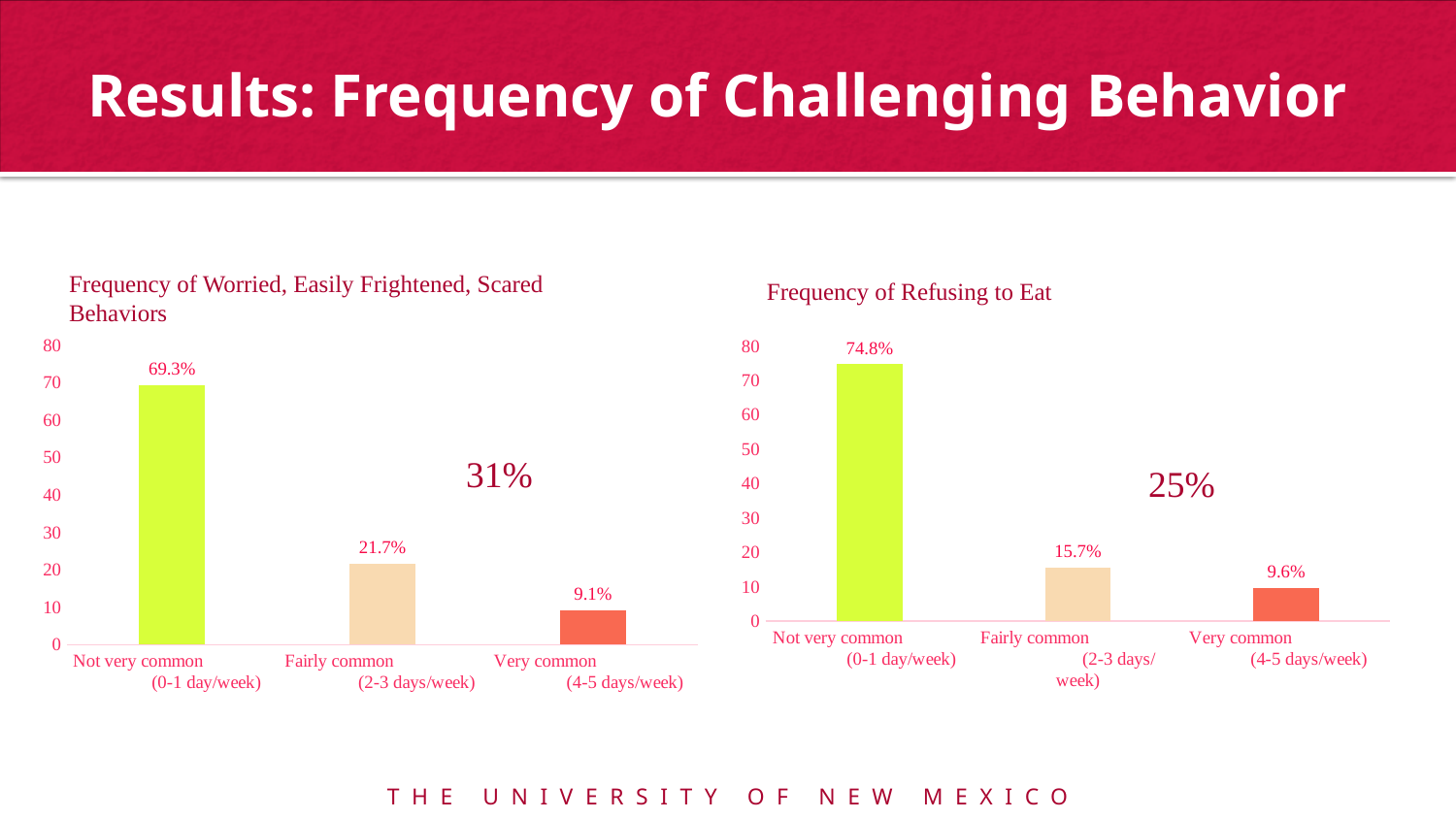
In the 'Frequency of Refusing to Eat' chart, what is the value for Fairly common (2-3 days/week)? 15.7% In the 'Frequency of Refusing to Eat' chart, what is the difference between the Fairly common and Very common values? 6.1% In the 'Frequency of Worried, Easily Frightened, Scared Behaviors' chart, what is the value for Not very common (0-1 day/week)? 69.3% In the 'Frequency of Worried, Easily Frightened, Scared Behaviors' chart, what is the value for Very common (4-5 days/week)? 9.1% In the 'Frequency of Refusing to Eat' chart, what is the value for Not very common (0-1 day/week)? 74.8% What type of chart is the 'Frequency of Worried, Easily Frightened, Scared Behaviors' chart? Bar chart How many categories are shown in the 'Frequency of Refusing to Eat' chart? 3 In the 'Frequency of Refusing to Eat' chart, which category has the lowest value? Very common (4-5 days/week) Which is larger: the Fairly common value in the 'Frequency of Worried, Easily Frightened, Scared Behaviors' chart or the Fairly common value in the 'Frequency of Refusing to Eat' chart? Frequency of Worried, Easily Frightened, Scared Behaviors (21.7%) In the 'Frequency of Worried, Easily Frightened, Scared Behaviors' chart, which category has the highest value? Not very common (0-1 day/week) What large percentage annotation is printed on the 'Frequency of Refusing to Eat' chart? 25% In the 'Frequency of Worried, Easily Frightened, Scared Behaviors' chart, what is the difference between the Not very common and Fairly common values? 47.6%